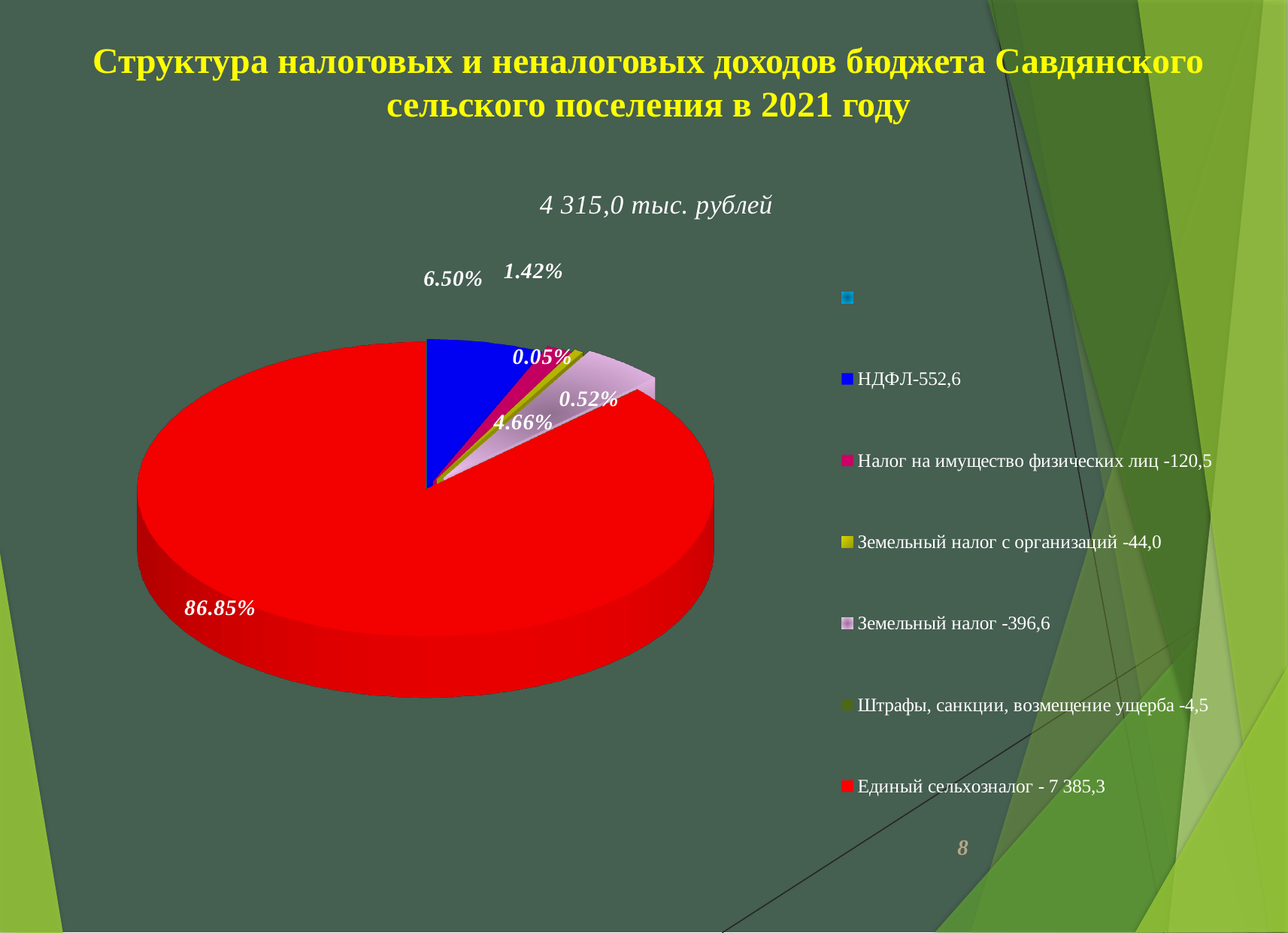
What type of chart is shown on the slide? pie chart What is the difference in percentage points between the НДФЛ share (6.50%) and the Налог на имущество физических лиц share (1.42%)? 5.08% What share of the pie does Единый сельхозналог (the red slice) represent? 86.85% What percentage is shown for Земельный налог (the pink slice)? 4.66% How many percentage labels are shown on the pie chart? 6 Which category has the smallest share of the pie? Штрафы, санкции, возмещение ущерба What value is given in the legend for Земельный налог с организаций? 44,0 What value in thousand rubles is printed above the pie chart? 4 315,0 тыс. рублей What percentage is shown for НДФЛ (the blue slice)? 6.50% Which is larger: the share for НДФЛ or the share for Земельный налог? НДФЛ Which category has the largest share of the pie? Единый сельхозналог What percentage is shown for Налог на имущество физических лиц (the magenta slice)? 1.42%